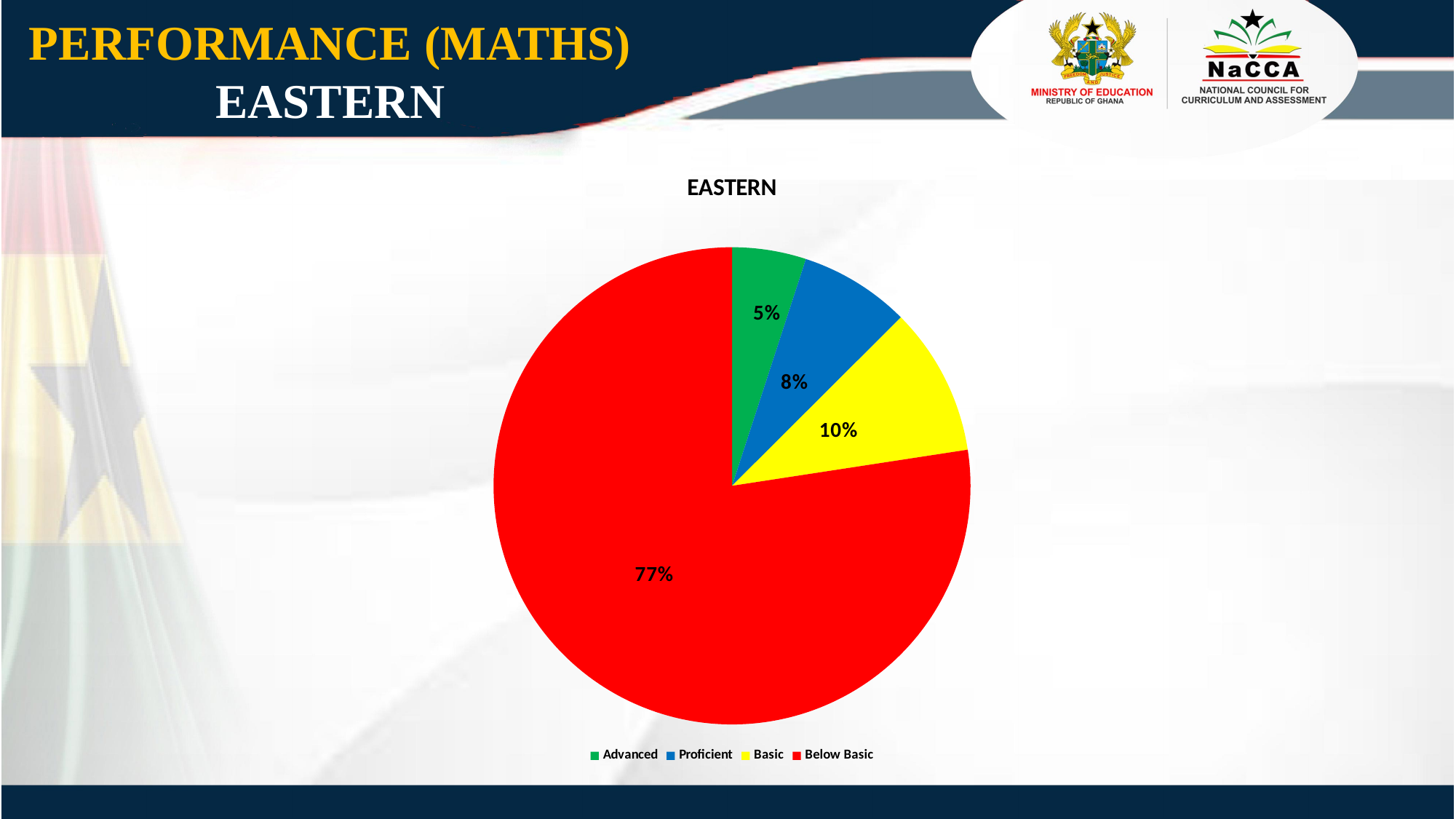
How many categories does the legend list? 4 What is the difference between the Below Basic share and the Basic share? 67% Which category has the largest share of the pie? Below Basic What is the title of the chart? EASTERN What colour is the Below Basic slice? red What percentage of the pie is labelled Below Basic? 77% What percentage of the pie is labelled Advanced? 5% What type of chart is shown on the slide? pie chart What percentage of the pie is labelled Proficient? 8% Which is larger, the Proficient share or the Basic share? Basic Which category has the smallest share of the pie? Advanced What percentage of the pie is labelled Basic? 10%